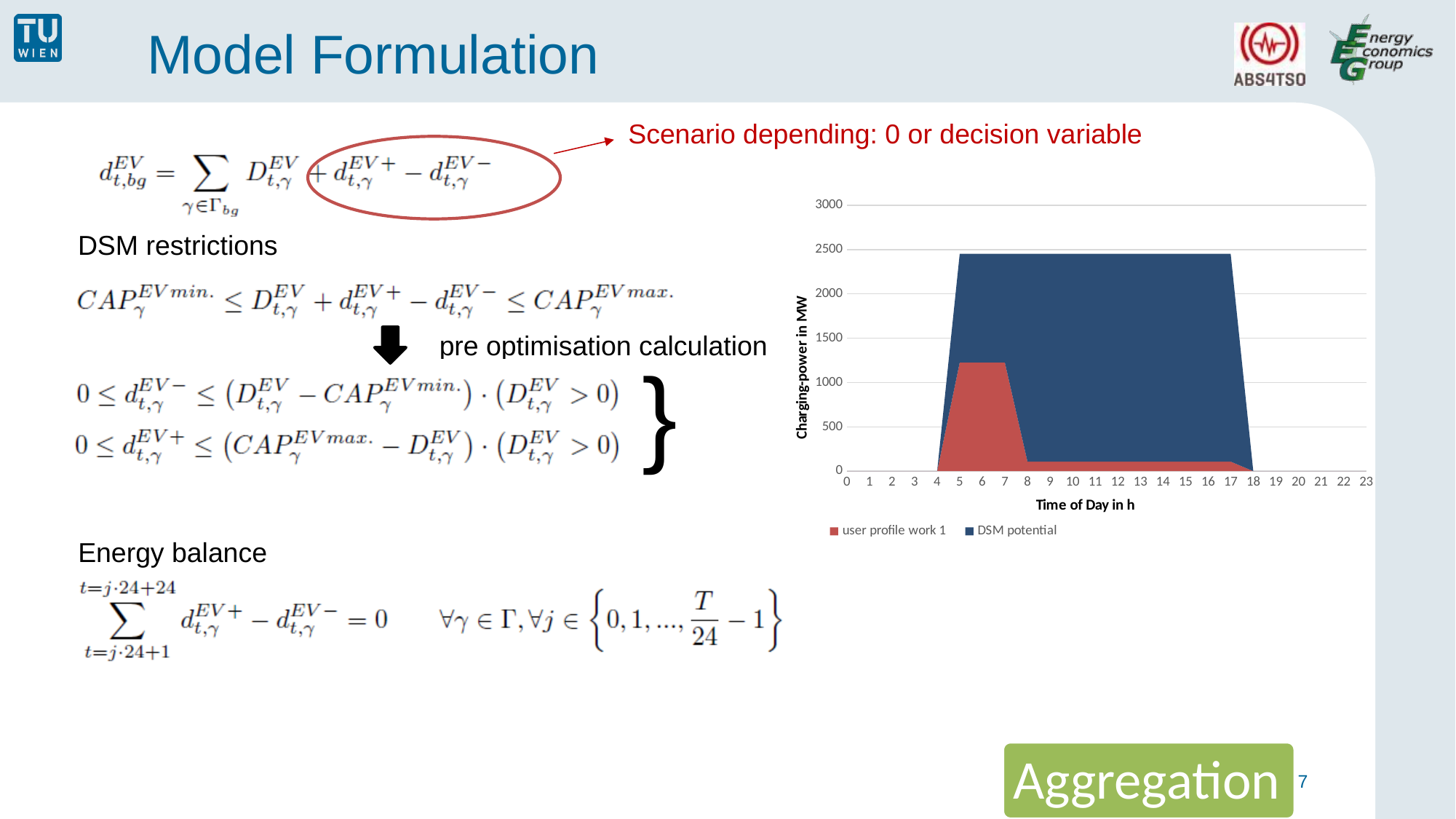
Is the value of user profile work 1 at hour 12 greater or less than 500? less What is the label of the chart's vertical axis? Charging-power in MW How many series does the chart legend list? 2 Is the peak value of user profile work 1 greater or less than 1500? less Is the value of DSM potential at hour 10 greater or less than 2000? greater How many hour ticks are labelled on the x axis of the chart? 24 What are the two series named in the chart legend? user profile work 1 and DSM potential Which series reaches the higher peak value, user profile work 1 or DSM potential? DSM potential What kind of chart is shown on the slide? area chart